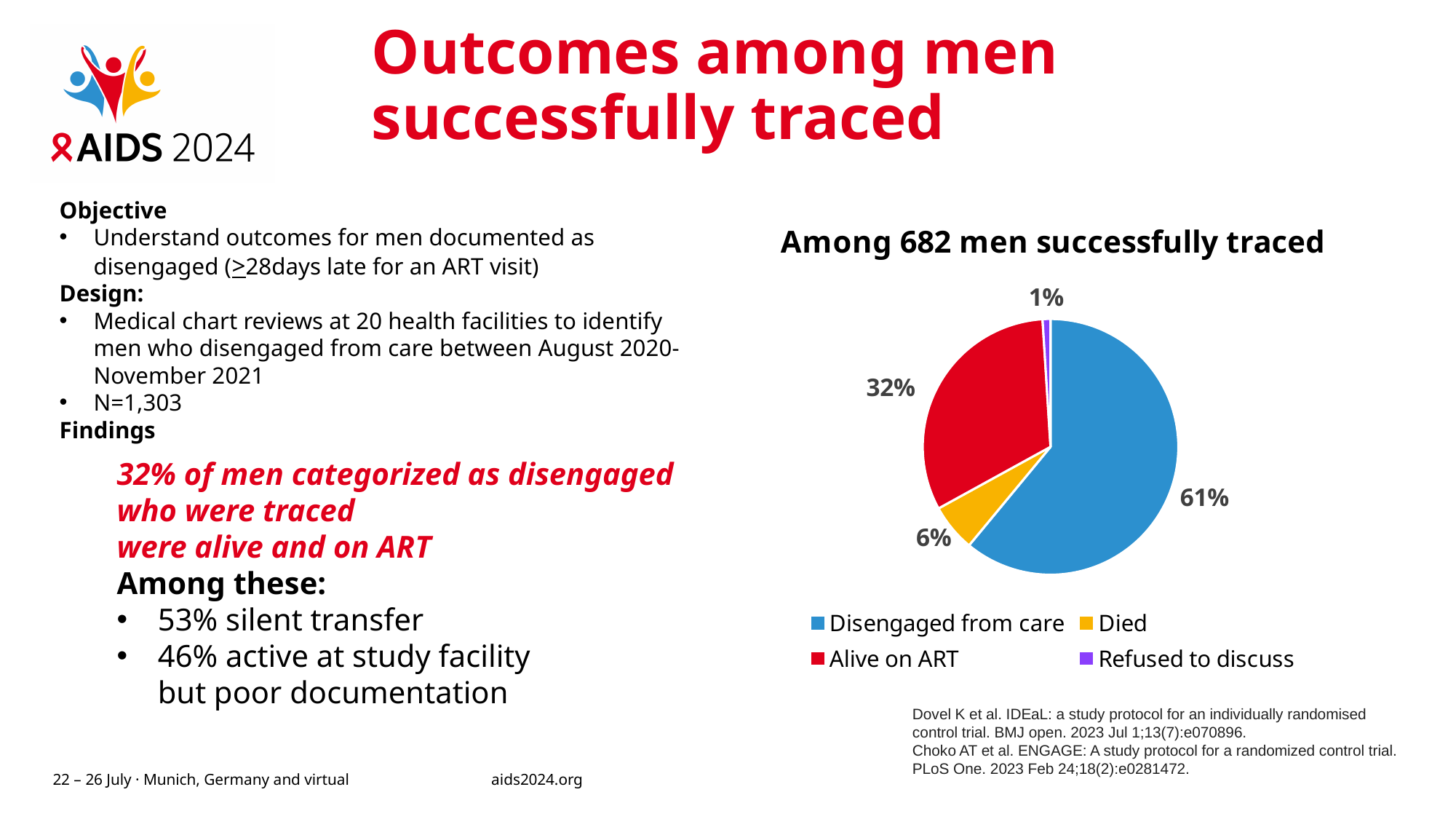
Which category has the smallest share of the pie? Refused to discuss What percentage of men successfully traced were alive on ART? 32% What percentage of men successfully traced were disengaged from care? 61% Which is larger: the share for Died or the share for Alive on ART? Alive on ART What is the difference in percentage points between Disengaged from care and Alive on ART? 29 What percentage of men successfully traced had died? 6% What percentage of men successfully traced refused to discuss? 1% What kind of chart is shown on the slide? Pie chart Which category has the largest share of the pie? Disengaged from care How many categories does the pie chart legend list? 4 What colour represents Alive on ART in the pie chart? Red What is the title of the pie chart? Among 682 men successfully traced